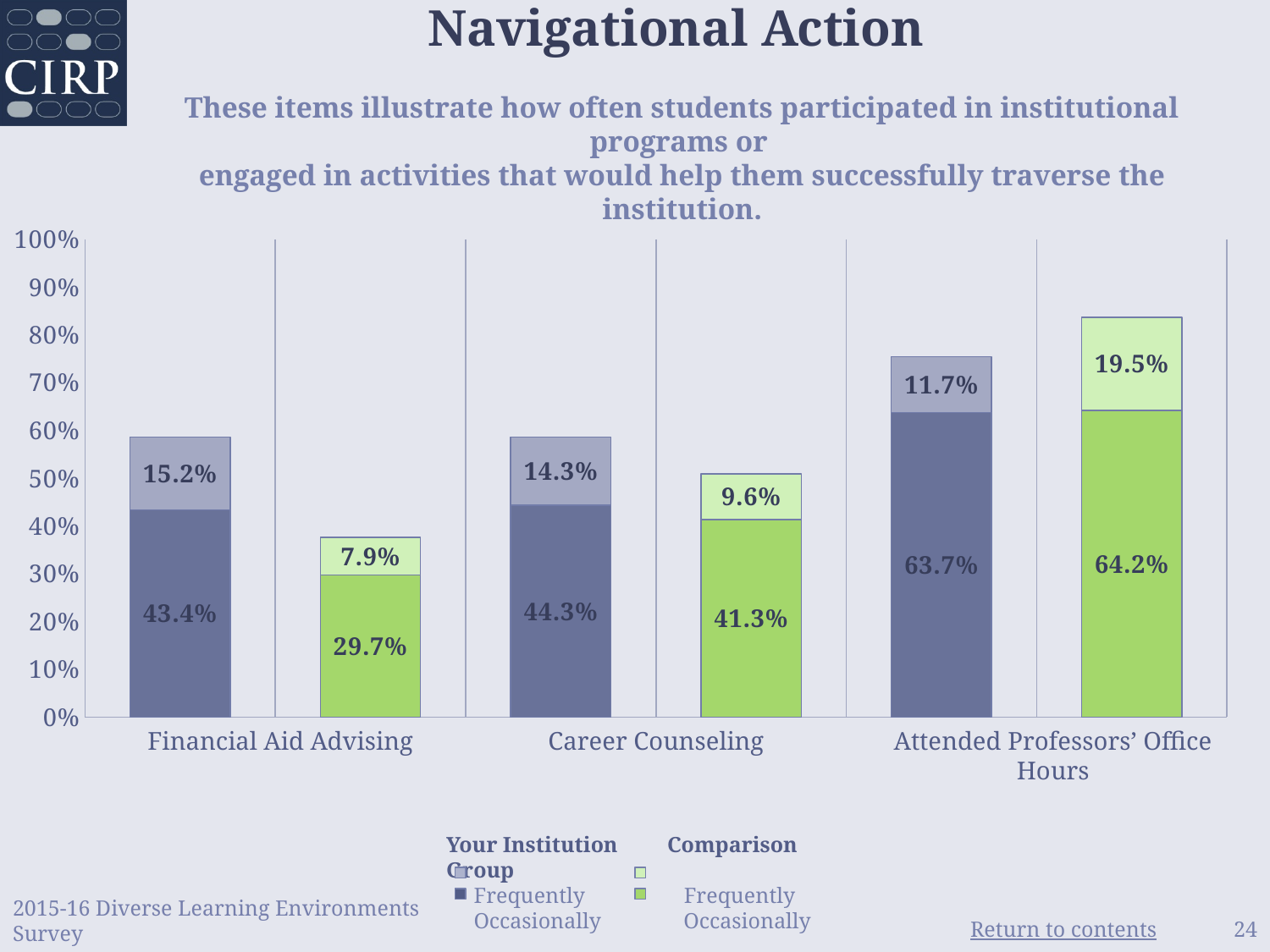
What is the Comparison Group's 'Frequently' value for Attended Professors' Office Hours? 19.5% Which category has the highest 'Frequently' value for Your Institution? Financial Aid Advising What is the total of Your Institution's stacked bar for Attended Professors' Office Hours? 75.4% What is the total of the Comparison Group's stacked bar for Financial Aid Advising? 37.6% Which category has the lowest 'Frequently' value for the Comparison Group? Financial Aid Advising How many categories are shown on the x axis of the chart? 3 Is the total of the Comparison Group's stacked bar for Attended Professors' Office Hours greater or less than 80%? greater What is the Comparison Group's 'Occasionally' value for Career Counseling? 41.3% What percentage of students at Your Institution reported frequently using Financial Aid Advising? 15.2% For Attended Professors' Office Hours, which group has the larger 'Occasionally' value, Your Institution or the Comparison Group? Comparison Group What is the difference between Your Institution's and the Comparison Group's 'Frequently' values for Financial Aid Advising? 7.3% What kind of chart is shown on the slide? Stacked bar chart